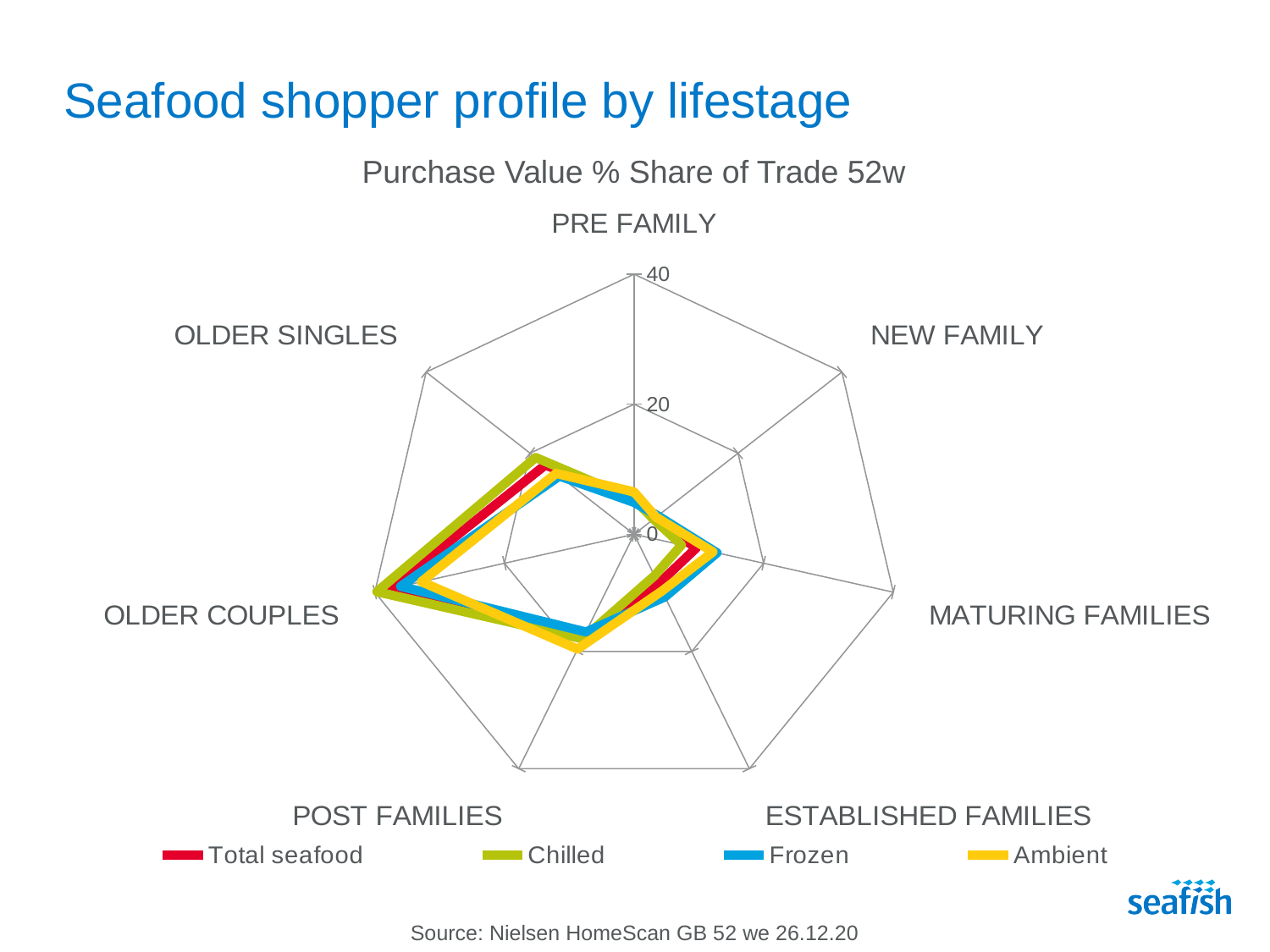
Is the Ambient value for New Family greater or less than 20? less Which lifestage has the highest share of trade for Chilled? Older Couples What kind of chart is shown on the slide? Radar chart Is the Total seafood value for Pre Family greater or less than 20? less How many lifestage categories are plotted on the chart? 7 How many series does the legend list? 4 Which lifestage has the highest share of trade for Total seafood? Older Couples Is the Frozen value for Maturing Families greater or less than 20? less For Total seafood, which is larger: the value for Older Couples or the value for Pre Family? Older Couples What is the highest value shown on the chart's axis scale? 40 What is the chart's title? Purchase Value % Share of Trade 52w